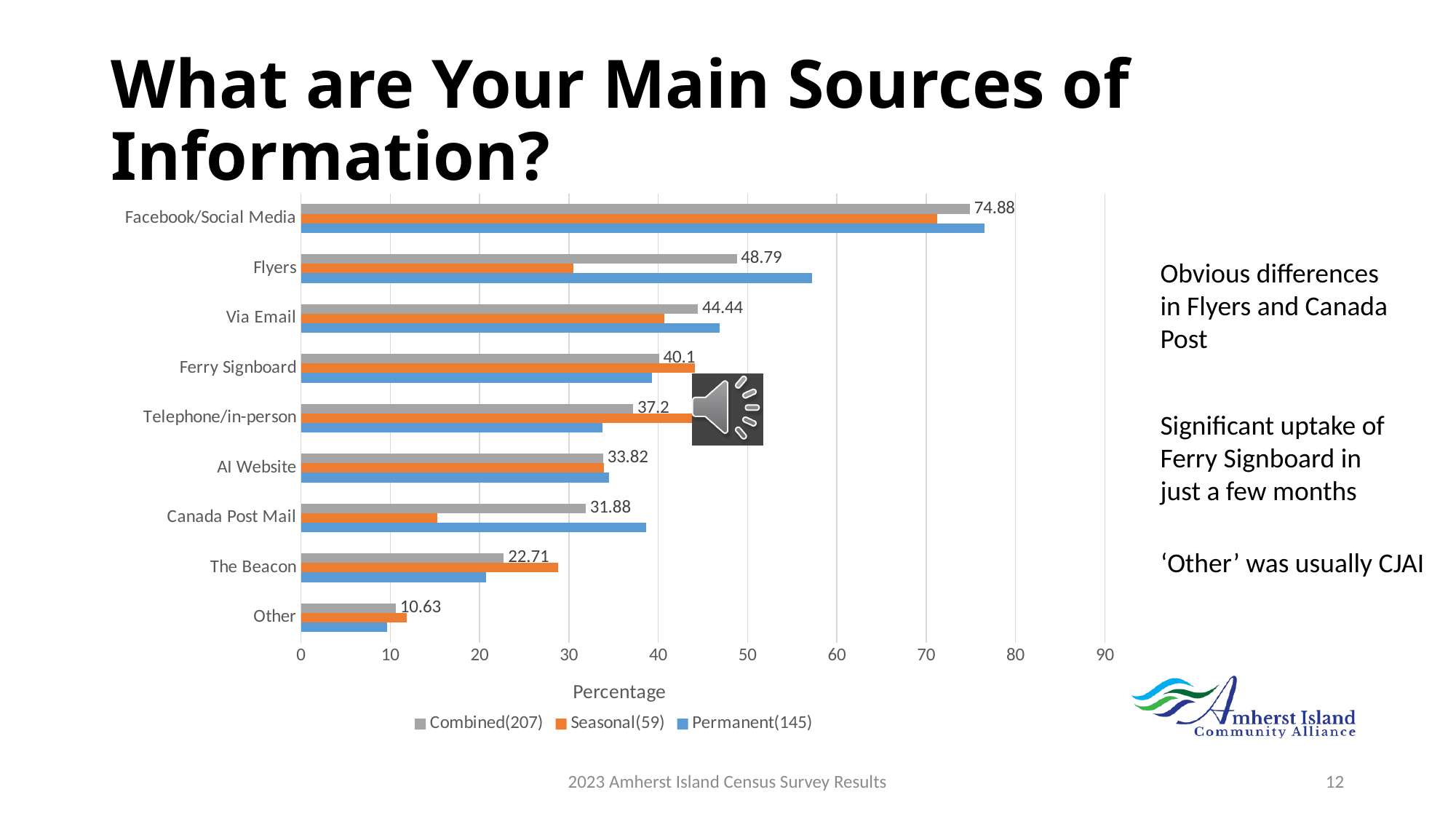
How many information source categories are shown on the chart? 9 What is the Combined(207) value for Facebook/Social Media? 74.88 For Flyers, which is larger: the Seasonal(59) value or the Permanent(145) value? Permanent(145) For The Beacon, which is larger: the Seasonal(59) value or the Permanent(145) value? Seasonal(59) Which information source has the highest Combined(207) value? Facebook/Social Media What is the Combined(207) value for Canada Post Mail? 31.88 How many series does the legend list? 3 Which information source has the lowest Combined(207) value? Other What is the Combined(207) value for Other? 10.63 What is the difference between the Combined(207) values for Flyers and Via Email? 4.35 Is the Seasonal(59) value for Canada Post Mail greater or less than 20? less Is the Permanent(145) value for Facebook/Social Media greater or less than 70? greater